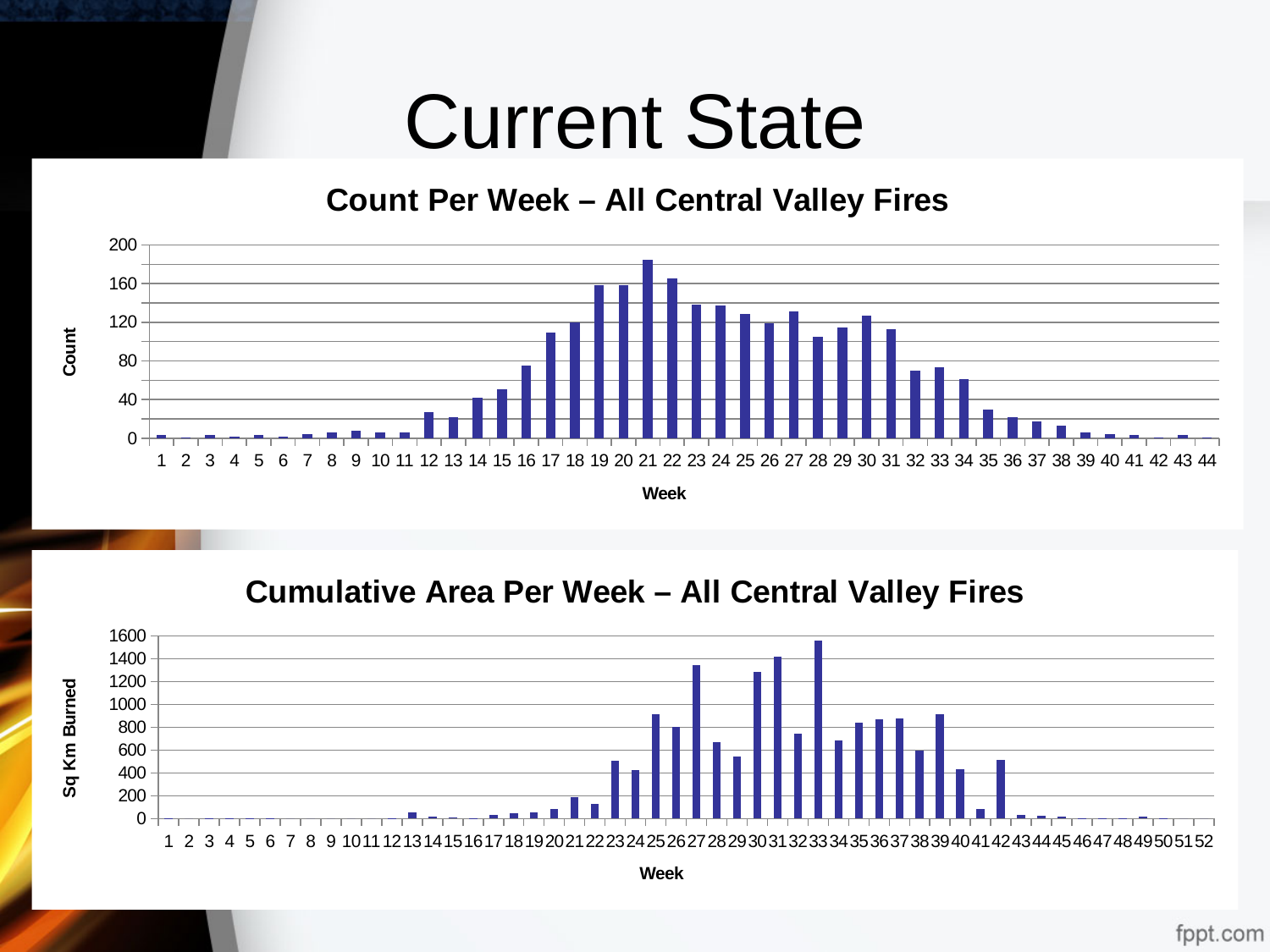
In the 'Count Per Week – All Central Valley Fires' chart, do the values generally rise or fall from week 21 to week 44? fall How many weeks are shown on the x axis of the 'Cumulative Area Per Week – All Central Valley Fires' chart? 52 In the 'Count Per Week – All Central Valley Fires' chart, is the value for week 21 greater or less than 160? greater In the 'Cumulative Area Per Week – All Central Valley Fires' chart, is the value for week 27 greater or less than 1200? greater In the 'Count Per Week – All Central Valley Fires' chart, which week has the highest count? 21 What is the y-axis label of the 'Cumulative Area Per Week – All Central Valley Fires' chart? Sq Km Burned What kind of chart is the 'Count Per Week – All Central Valley Fires' chart? bar chart In the 'Cumulative Area Per Week – All Central Valley Fires' chart, which week has the highest value? 33 How many weeks are shown on the x axis of the 'Count Per Week – All Central Valley Fires' chart? 44 In the 'Count Per Week – All Central Valley Fires' chart, is the value for week 17 greater or less than 80? greater